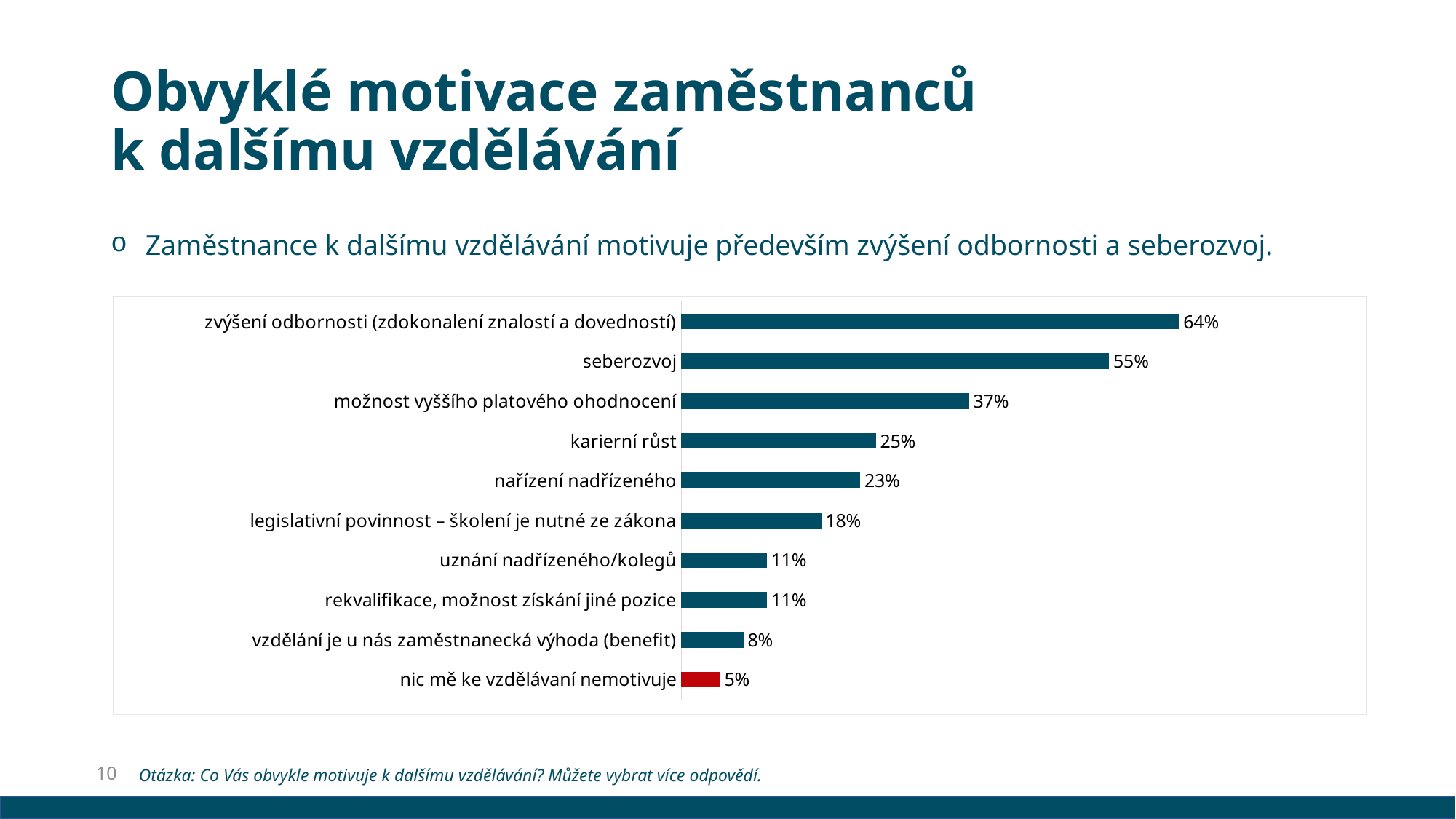
What is the difference between the values for "možnost vyššího platového ohodnocení" and "nařízení nadřízeného"? 14% Which category has the highest value? zvýšení odbornosti (zdokonalení znalostí a dovedností) What is the value for "vzdělání je u nás zaměstnanecká výhoda (benefit)"? 8% What is the difference between the values for "zvýšení odbornosti (zdokonalení znalostí a dovedností)" and "seberozvoj"? 9% How many categories are shown in the chart? 10 Which bar is coloured red instead of dark blue? nic mě ke vzdělávaní nemotivuje Which category has the lowest value? nic mě ke vzdělávaní nemotivuje Which is larger: the value for "karierní růst" or the value for "legislativní povinnost – školení je nutné ze zákona"? karierní růst What is the value for "legislativní povinnost – školení je nutné ze zákona"? 18% What is the value for "karierní růst"? 25% What is the value for "seberozvoj"? 55% What kind of chart is shown on the slide? bar chart